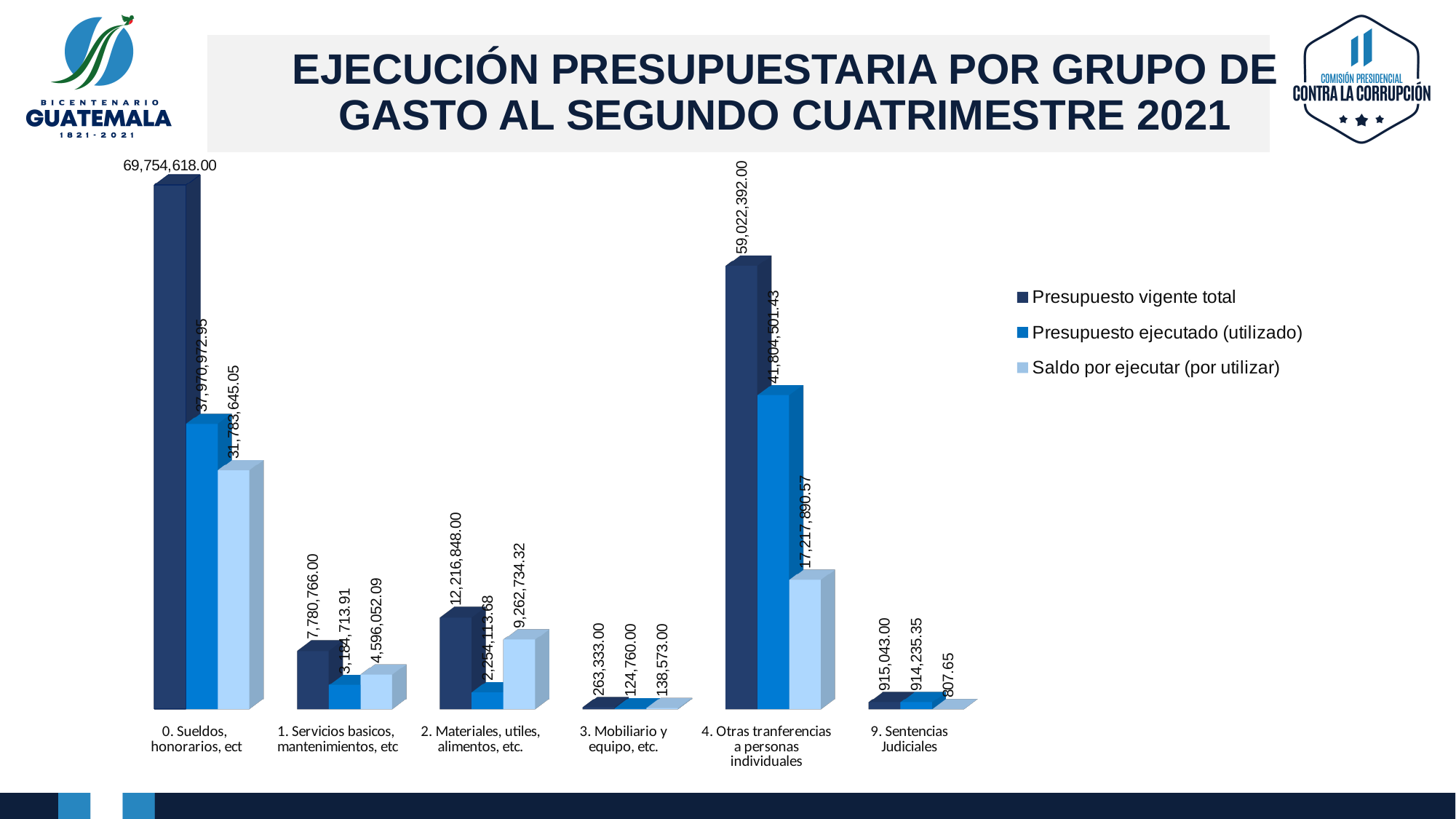
Which category has the highest Presupuesto vigente total? 0. Sueldos, honorarios, ect What is the Presupuesto vigente total for '9. Sentencias Judiciales'? 915,043.00 How many series does the legend list? 3 What kind of chart is shown on the slide? Bar chart What is the Saldo por ejecutar (por utilizar) for '4. Otras tranferencias a personas individuales'? 17,217,890.57 What is the difference between the Presupuesto vigente total and the Presupuesto ejecutado (utilizado) for '9. Sentencias Judiciales'? 807.65 Which has a larger Saldo por ejecutar (por utilizar): '2. Materiales, utiles, alimentos, etc.' or '1. Servicios basicos, mantenimientos, etc'? 2. Materiales, utiles, alimentos, etc. Which category has the lowest Presupuesto vigente total? 3. Mobiliario y equipo, etc. How many expense group categories are shown on the x axis? 6 What is the difference between the Presupuesto vigente total and the Saldo por ejecutar (por utilizar) for '4. Otras tranferencias a personas individuales'? 41,804,501.43 What is the Presupuesto ejecutado (utilizado) for '3. Mobiliario y equipo, etc.'? 124,760.00 What is the Presupuesto vigente total for '0. Sueldos, honorarios, ect'? 69,754,618.00